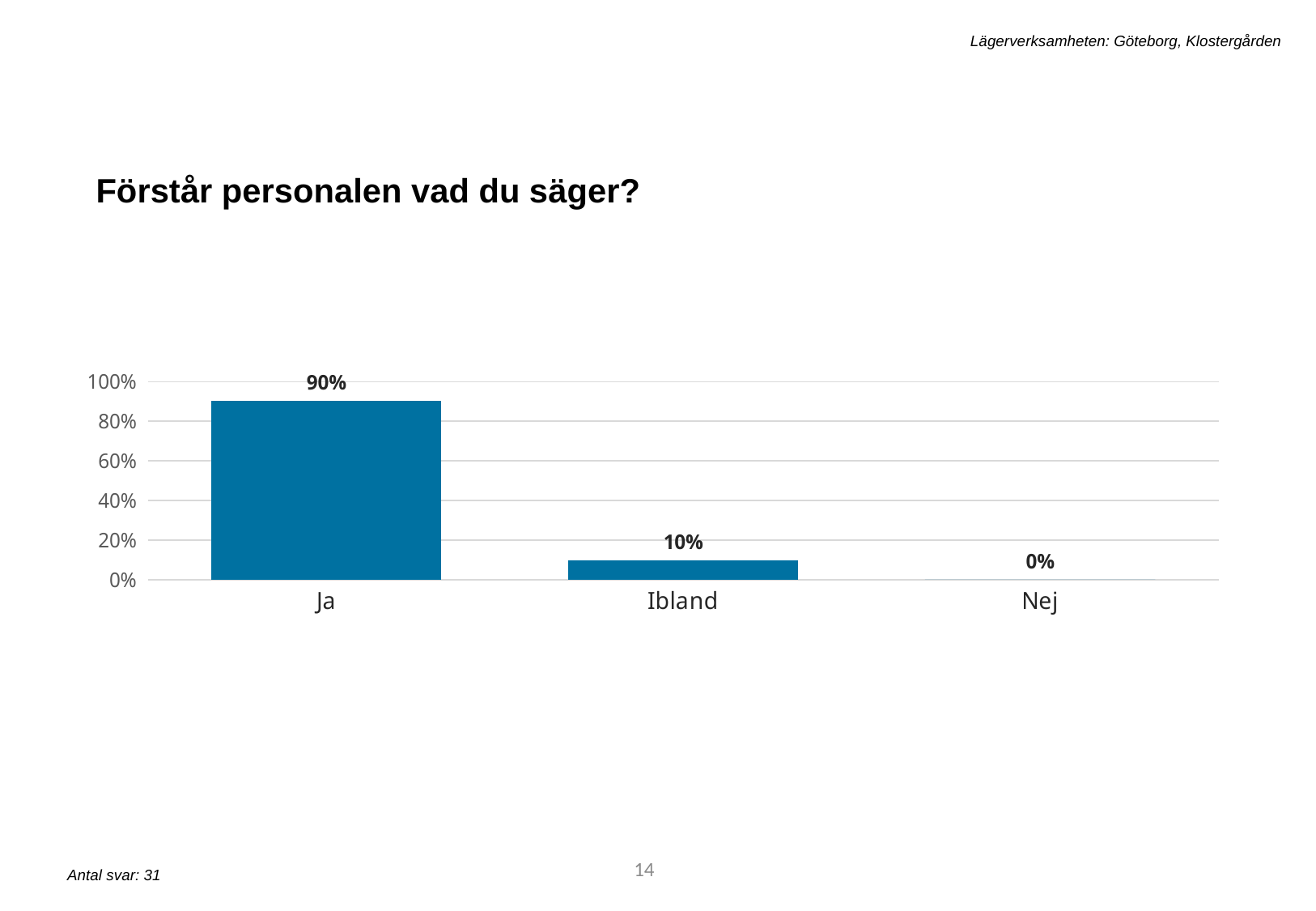
Which category has the lowest value? Nej What is the title of the chart? Förstår personalen vad du säger? How many categories are shown on the x axis? 3 Which category has the highest value? Ja What kind of chart is shown on the slide? bar chart What is the difference between the values for Ja and Ibland? 80% Which is larger, the value for Ibland or the value for Nej? Ibland What is the value for Ibland? 10% What is the value for Nej? 0% What is the value for Ja? 90% Do the values rise or fall from Ja to Nej along the x axis? fall Is the value for Ja greater or less than 80%? greater